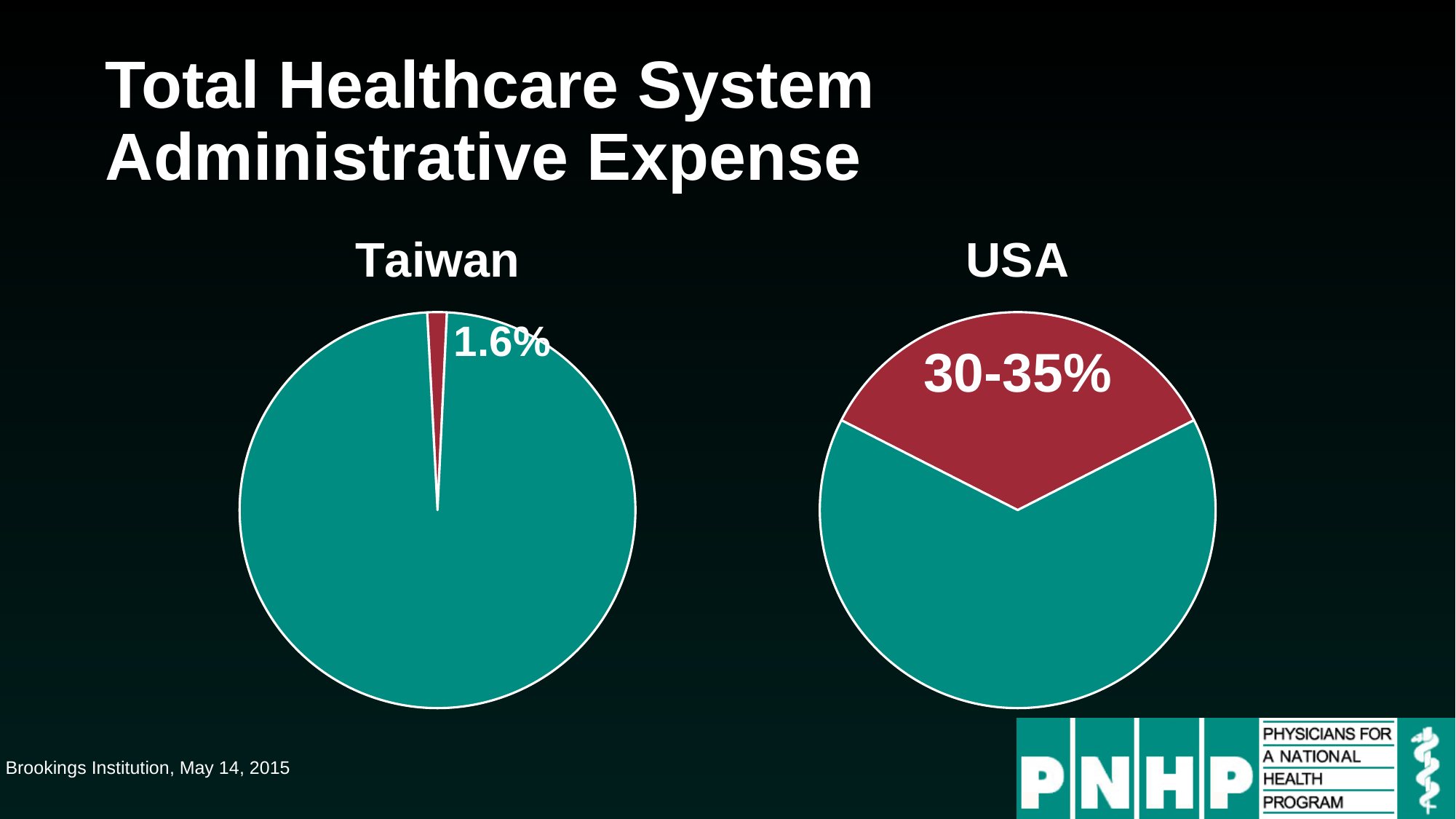
In the USA pie chart, what share is labelled on the red slice? 30-35% In the Taiwan pie chart, is the red slice greater or less than 10%? less In the USA pie chart, is the red slice greater or less than 50%? less What colour is the slice representing administrative expense in both pie charts? Red Which pie chart, Taiwan or USA, shows the smaller administrative expense share? Taiwan In the Taiwan pie chart, what share is labelled on the red slice? 1.6% How many pie charts are shown on the slide? 2 Which pie chart, Taiwan or USA, shows the larger red slice? USA What kind of chart is used for Taiwan on the slide? Pie chart What is the title of the slide containing the two pie charts? Total Healthcare System Administrative Expense How many slices does the USA pie chart have? 2 How many slices does the Taiwan pie chart have? 2